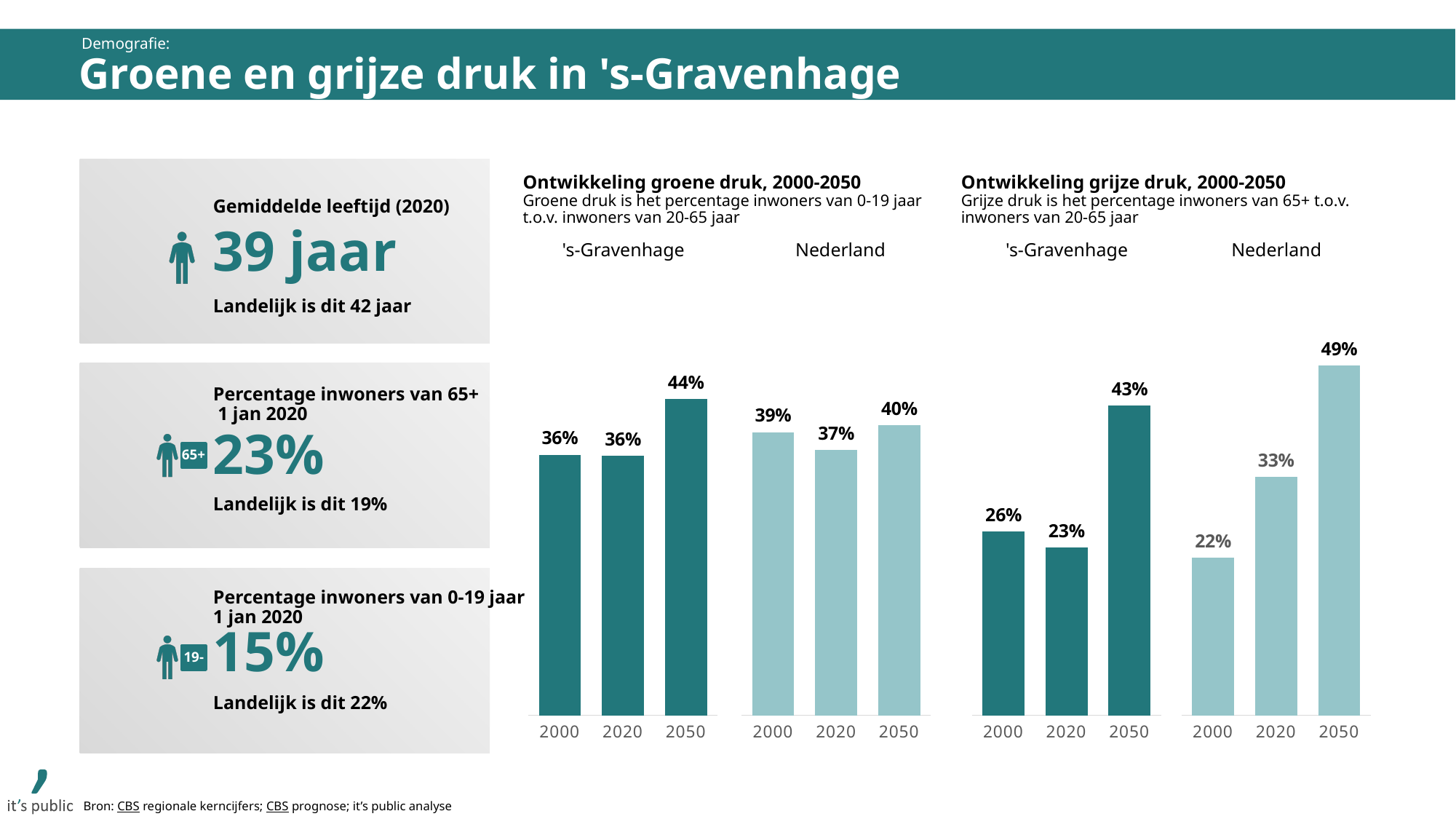
In the 'Ontwikkeling groene druk, 2000-2050' chart, what is the value for Nederland in 2020? 37% In the 'Ontwikkeling grijze druk, 2000-2050' chart, do the Nederland values rise or fall from 2000 to 2050? Rise In the 'Ontwikkeling grijze druk, 2000-2050' chart, what is the difference between the Nederland value for 2050 and the 's-Gravenhage value for 2050? 6 percentage points In the 'Ontwikkeling grijze druk, 2000-2050' chart, which bar has the highest value? Nederland 2050 In the 'Ontwikkeling grijze druk, 2000-2050' chart, which bar has the lowest value? Nederland 2000 In the 'Ontwikkeling groene druk, 2000-2050' chart, what is the difference between the 's-Gravenhage values for 2050 and 2020? 8 percentage points In the 'Ontwikkeling grijze druk, 2000-2050' chart, what is the value for Nederland in 2000? 22% In the 'Ontwikkeling groene druk, 2000-2050' chart, what is the value for 's-Gravenhage in 2050? 44% How many bars are shown in the 'Ontwikkeling groene druk, 2000-2050' chart? 6 What type of chart is 'Ontwikkeling grijze druk, 2000-2050'? Bar chart In the 'Ontwikkeling groene druk, 2000-2050' chart, which is larger: the 2000 value for 's-Gravenhage or the 2000 value for Nederland? Nederland In the 'Ontwikkeling grijze druk, 2000-2050' chart, what is the value for 's-Gravenhage in 2020? 23%